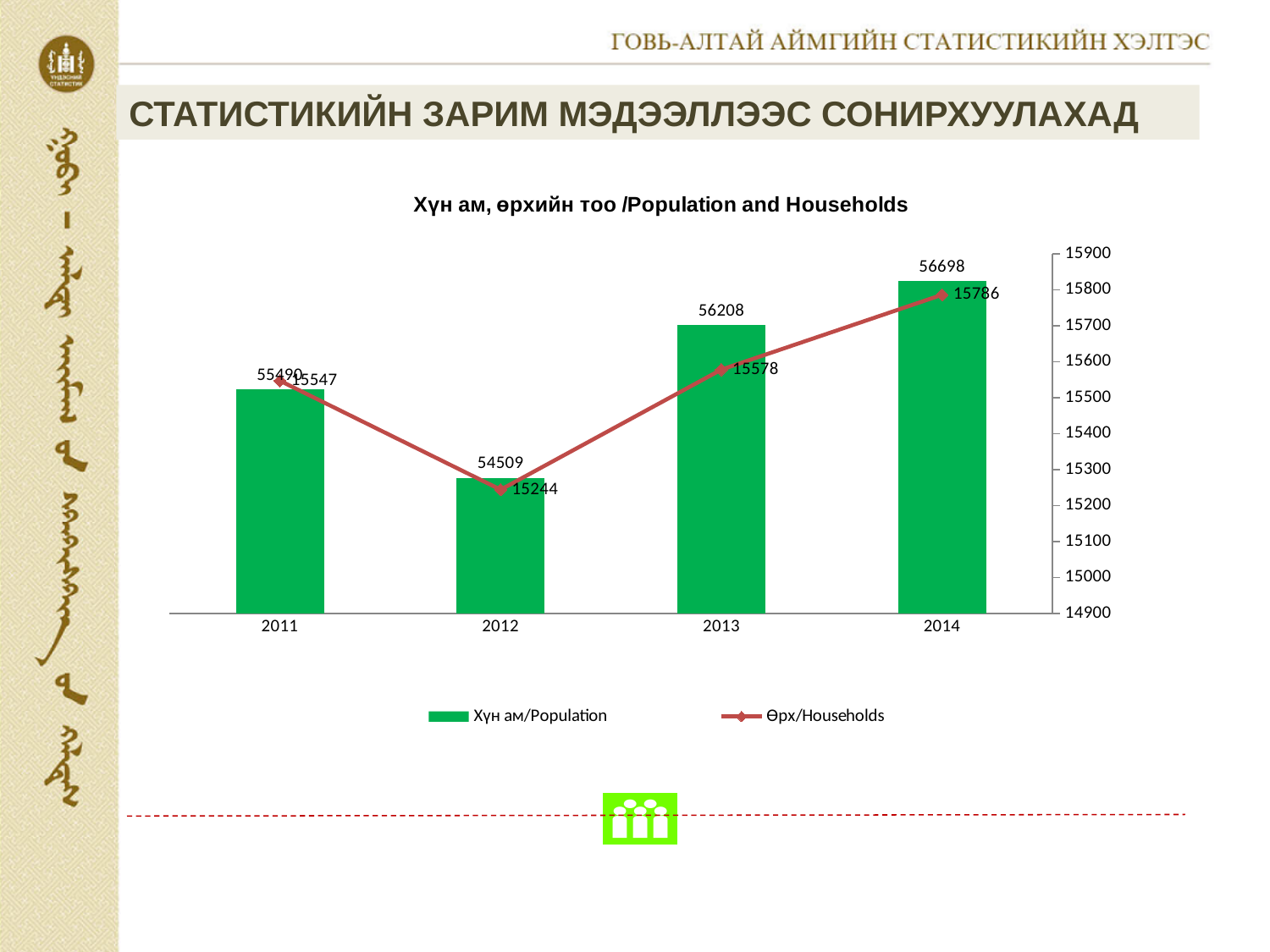
What is the title of the chart? Хүн ам, өрхийн тоо /Population and Households Which year has the highest Population? 2014 What is the difference between the Households value in 2014 and in 2012? 542 What is the difference between the Population in 2014 and in 2013? 490 Which year has the lowest Households value? 2012 What is the Households value for 2014? 15786 How many series does the legend list? 2 How many years are shown on the x axis? 4 What is the Population value for 2012? 54509 What is the Households value for 2012? 15244 What is the Population value for 2013? 56208 Which is larger, the Households value in 2013 or in 2011? 2013